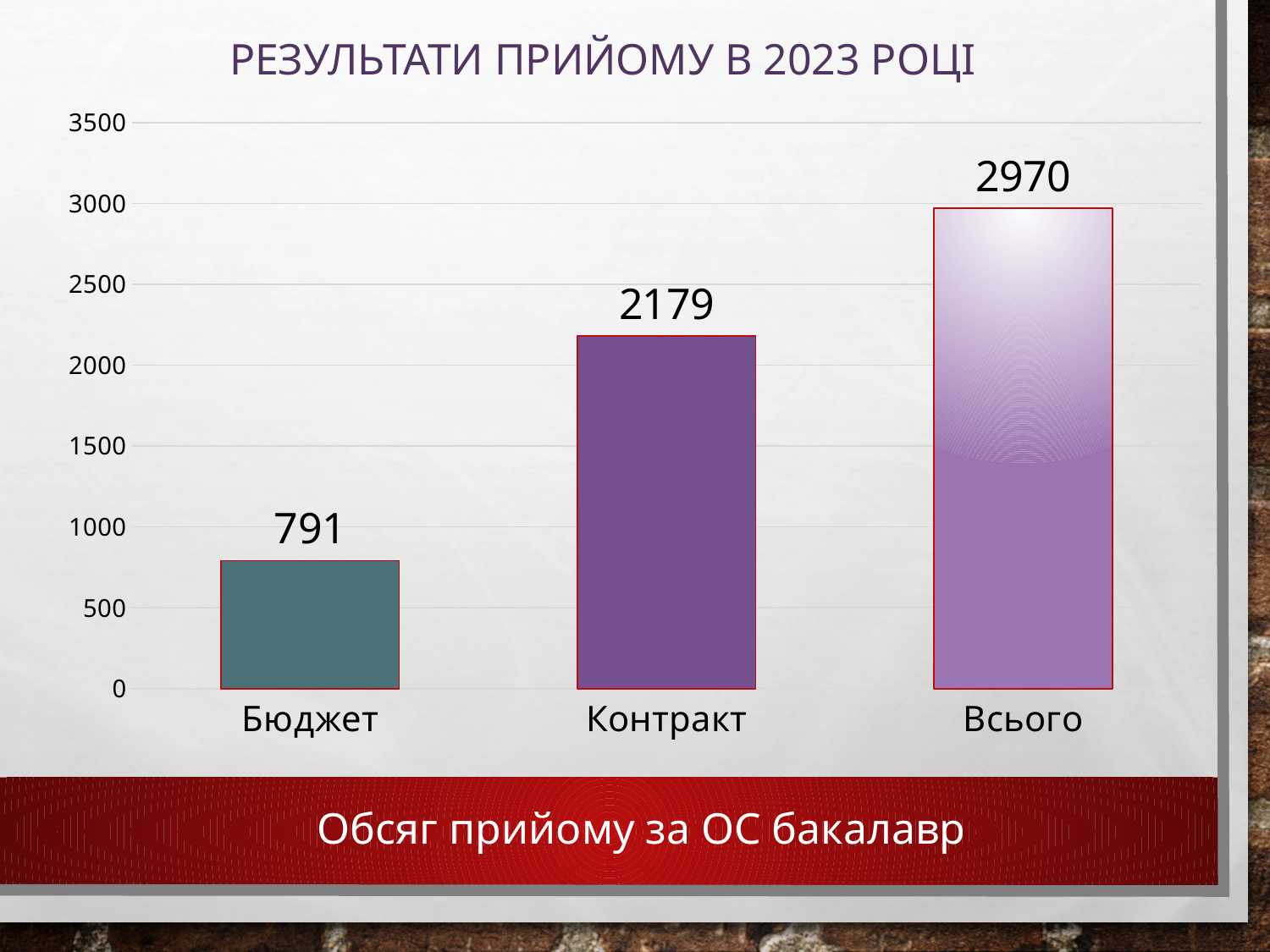
What is the value for Бюджет? 791 What kind of chart is shown on the slide? bar chart How many categories are shown on the chart? 3 What is the value for Всього? 2970 Which is larger, the value for Бюджет or the value for Контракт? Контракт What is the title of the chart? РЕЗУЛЬТАТИ ПРИЙОМУ В 2023 РОЦІ What is the difference between the values for Всього and Контракт? 791 Is the value for Контракт greater or less than 2000? greater What is the difference between the values for Контракт and Бюджет? 1388 Which category has the lowest value? Бюджет What is the value for Контракт? 2179 Which category has the highest value? Всього